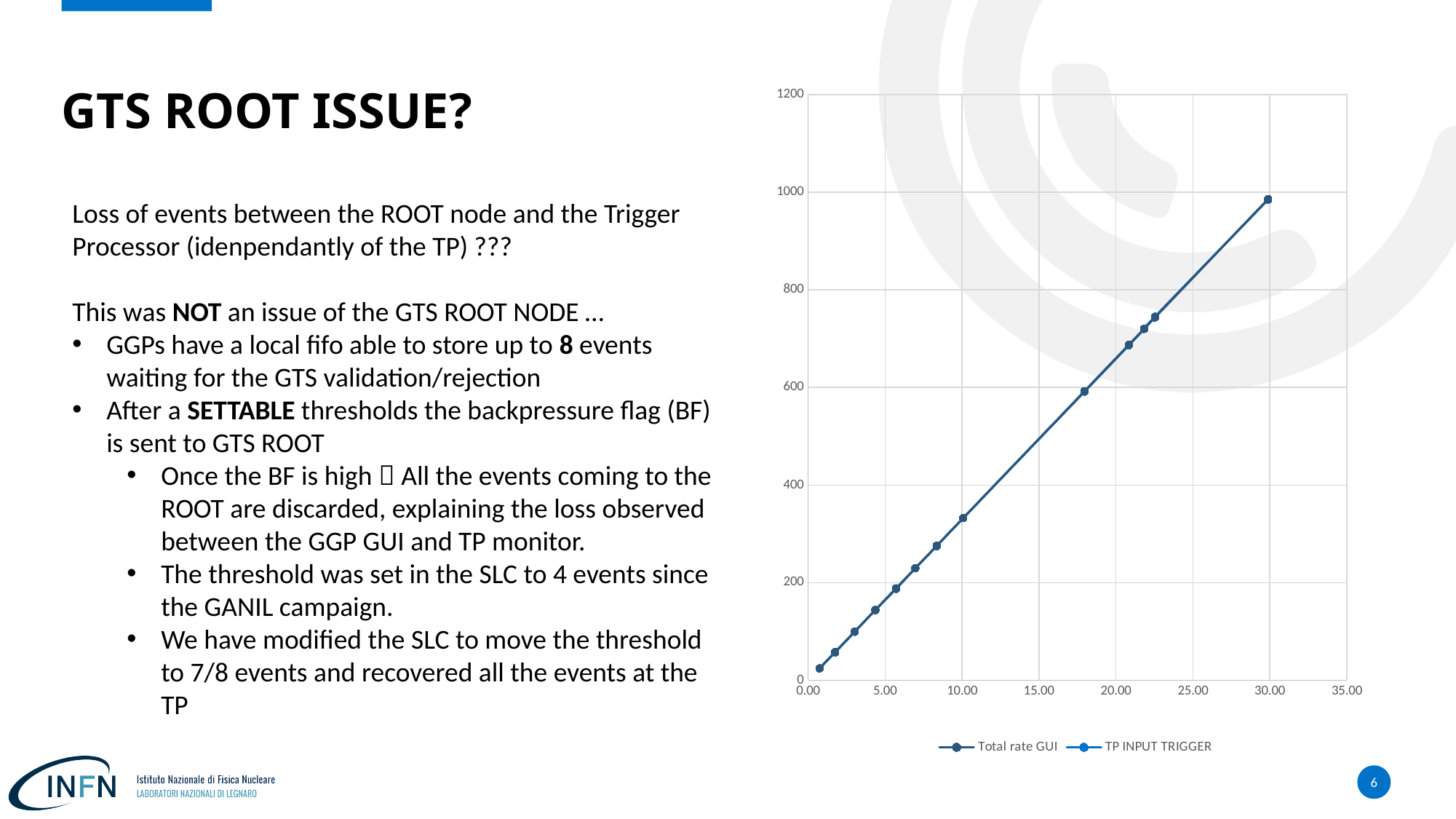
What kind of chart is shown on the slide? line chart What are the names of the two series in the chart legend? Total rate GUI and TP INPUT TRIGGER Which x-axis position has the highest plotted value, 30.00 or 10.00? 30.00 Do the plotted values rise or fall as the x-axis value increases? rise How many series does the chart legend list? 2 Is the value of Total rate GUI at x = 10.00 greater or less than 400? less What is the highest tick value shown on the y-axis of the chart? 1200 Is the value of Total rate GUI at x = 30.00 greater or less than 800? greater Is the value of Total rate GUI at x = 18.00 greater or less than 400? greater